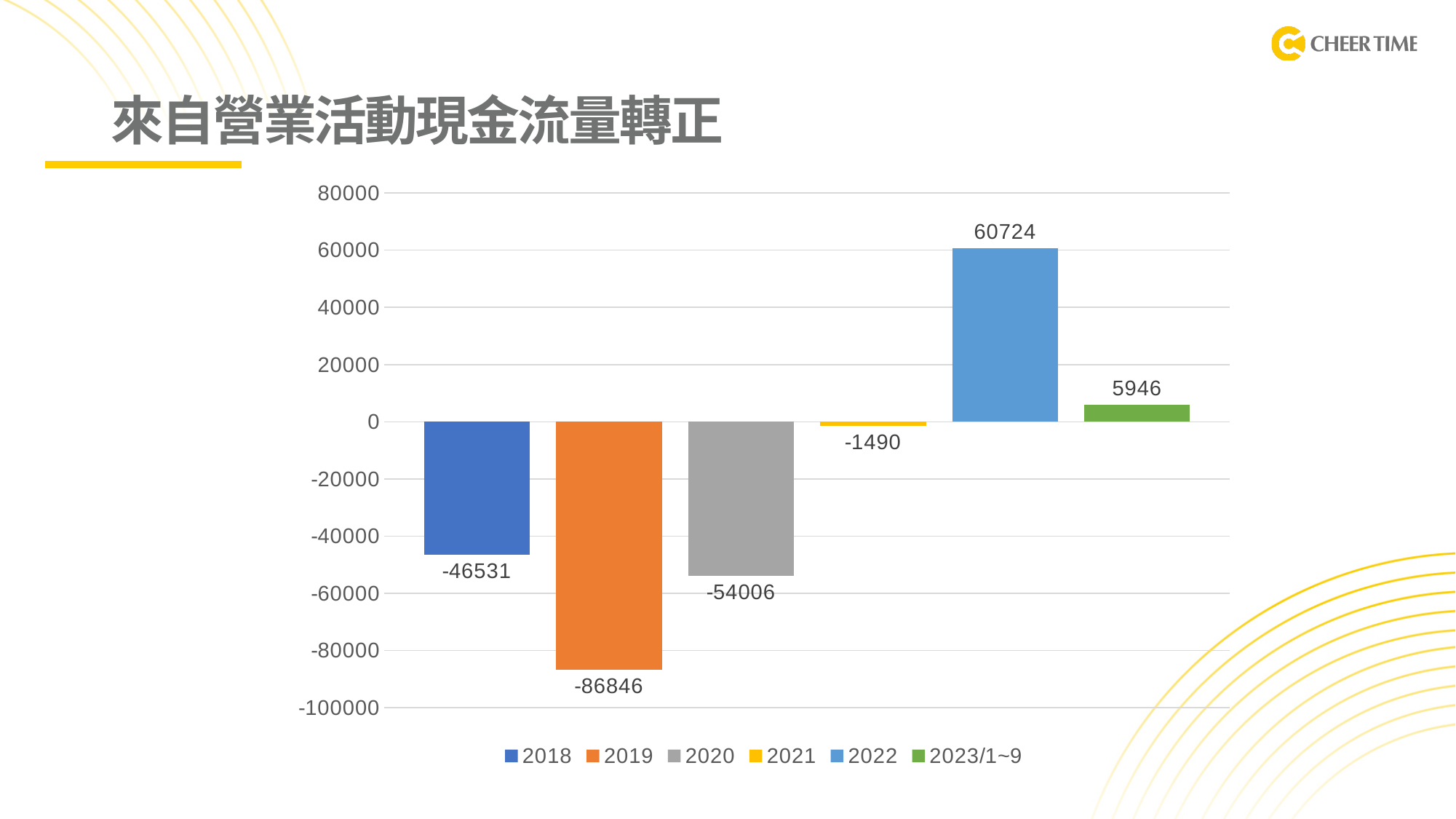
How many entries does the legend list? 6 Which year has the lowest value? 2019 What is the value for 2019? -86846 Which year has the highest value? 2022 What kind of chart is shown on the slide? Bar chart What is the value for 2021? -1490 What is the value for 2022? 60724 Which is larger, the value for 2018 or the value for 2020? 2018 What is the value for 2023/1~9? 5946 What is the difference between the values for 2018 and 2020? 7475 What is the difference between the values for 2022 and 2023/1~9? 54778 How many bars are plotted in the chart? 6